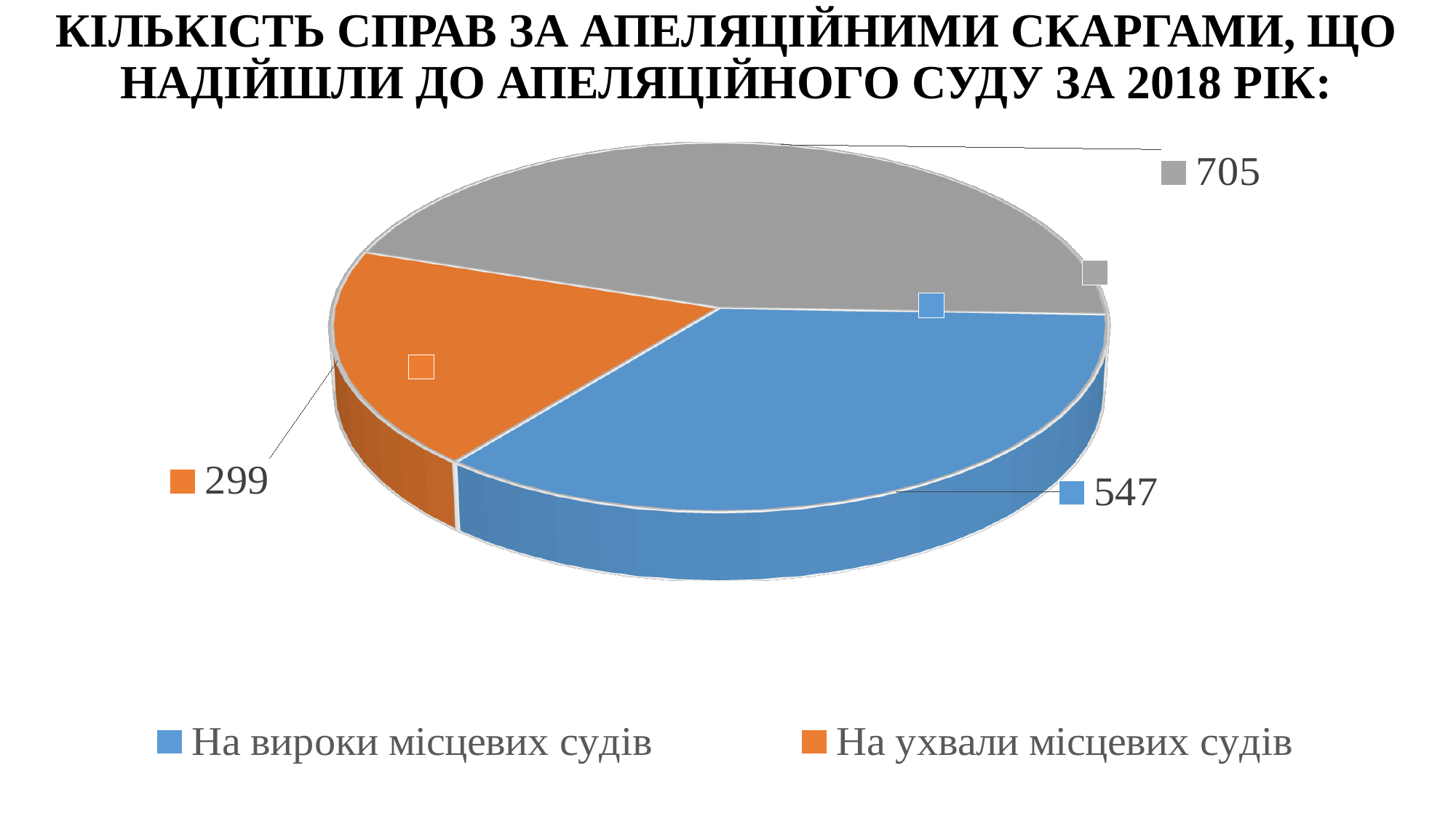
Which is larger: "На вироки місцевих судів" or "На ухвали місцевих судів"? На вироки місцевих судів Which of the two legend categories has the smallest value? На ухвали місцевих судів Which slice of the pie has the largest value? the gray slice (705) What is the value for "На ухвали місцевих судів"? 299 By how much does the gray slice (705) exceed the blue slice (547)? 158 What is the value for "На вироки місцевих судів"? 547 What is the total of all three values shown on the pie chart? 1551 How many entries does the legend list? 2 How many slices does the pie chart have? 3 What is the difference between the values for "На вироки місцевих судів" and "На ухвали місцевих судів"? 248 What kind of chart is shown on the slide? pie chart What value is labelled on the gray slice of the pie? 705